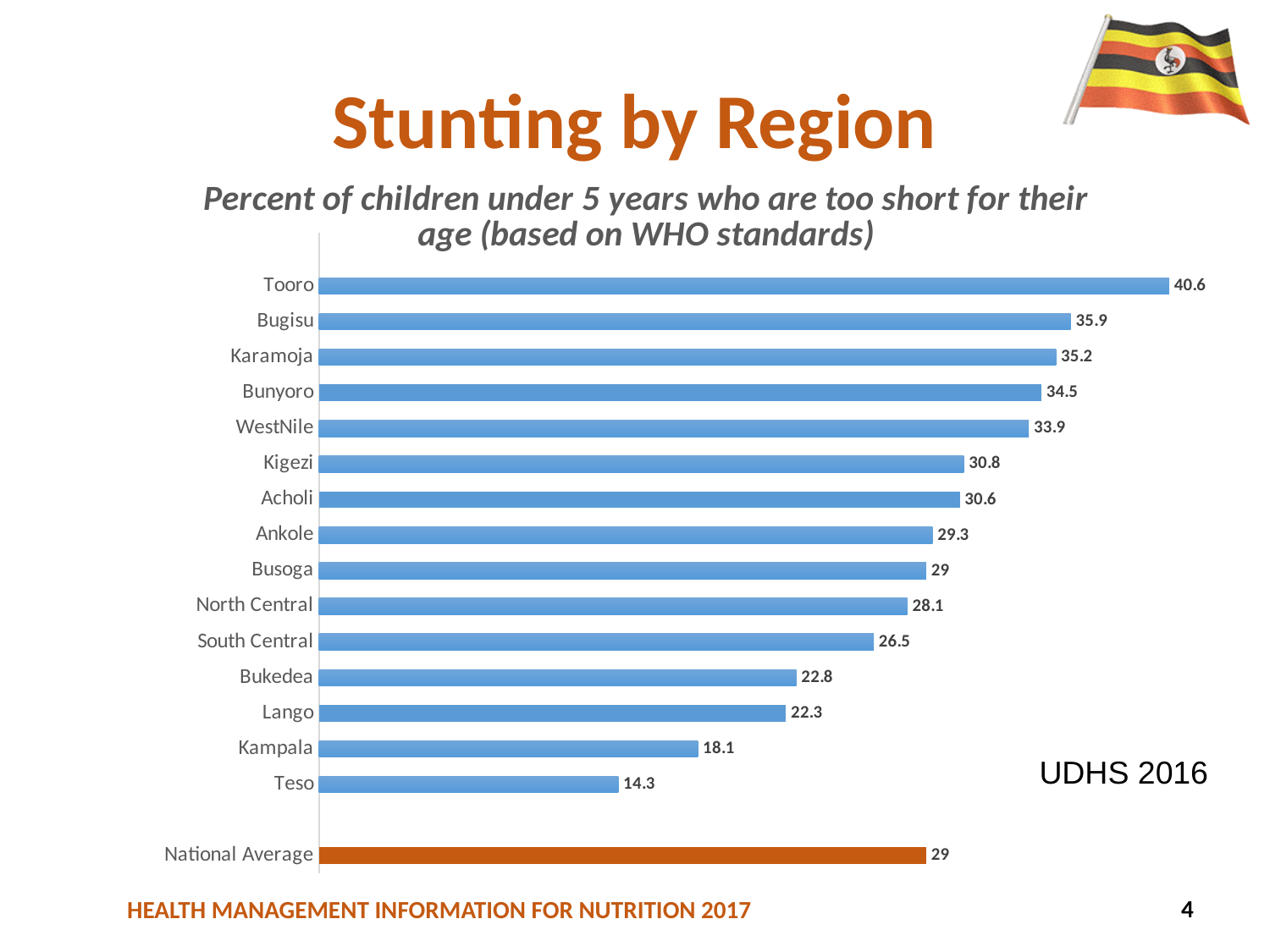
How many regions are plotted, excluding the National Average bar? 15 What kind of chart is shown on the slide? Bar chart Which region has the lowest stunting value? Teso Which has a larger value, Kigezi or Lango? Kigezi What is the value for the National Average bar? 29 Which bar is shown in a different colour (orange) from the others? National Average What is the stunting value for Tooro? 40.6 Which region has the highest stunting value? Tooro What is the value shown for Kampala? 18.1 What is the difference between the values for Bugisu and Karamoja? 0.7 Which has a larger value, Bukedea or South Central? South Central What is the difference between the values for Tooro and Teso? 26.3